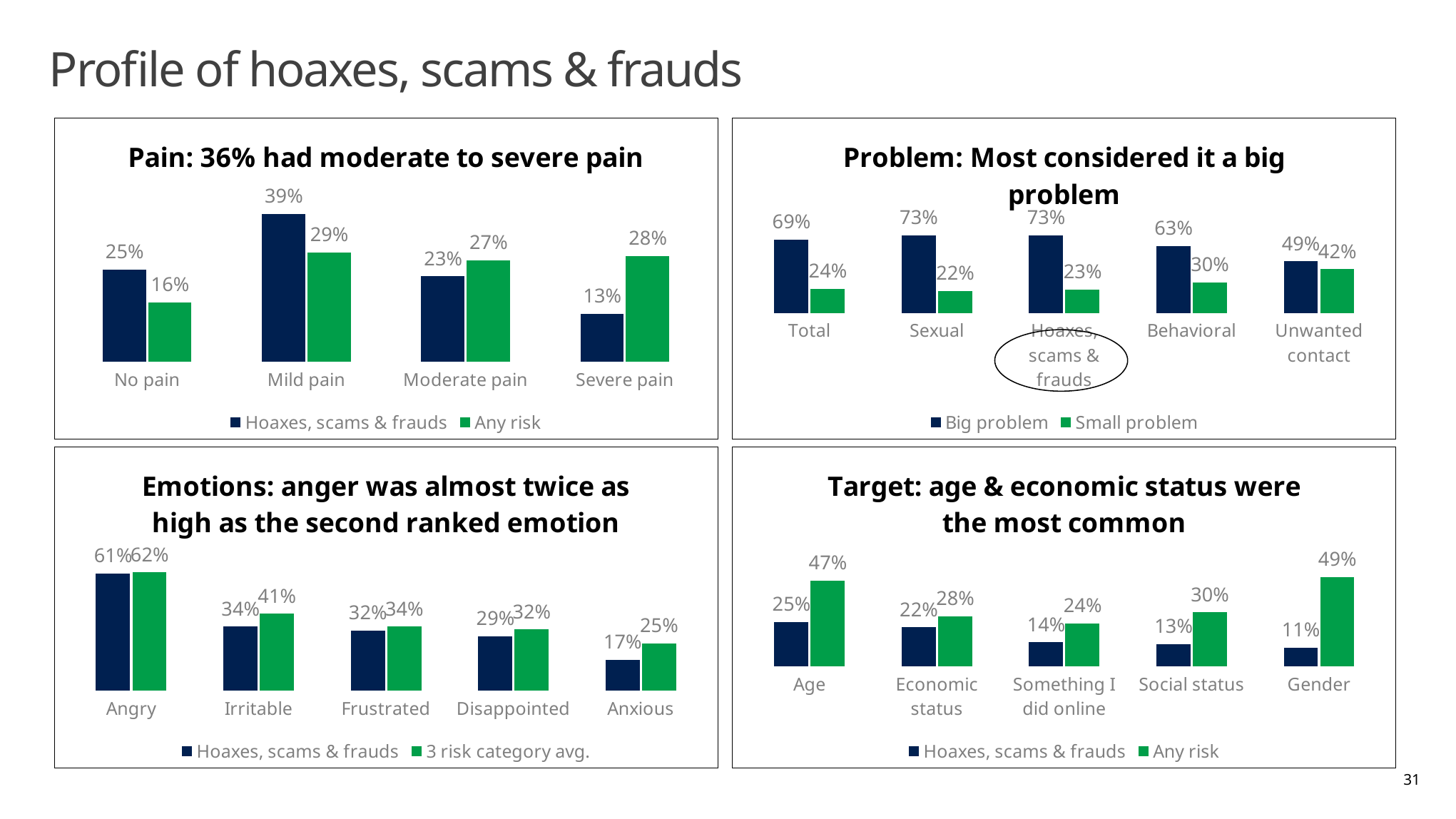
In the Target chart, what is the Any risk value for Gender? 49% What kind of chart is the Target chart? Bar chart In the Problem chart, what is the Big problem value for Behavioral? 63% In the Target chart, which is larger for Social status: Hoaxes, scams & frauds or Any risk? Any risk In the Pain chart, which category has the lowest value for Hoaxes, scams & frauds? Severe pain In the Pain chart, what is the value for Mild pain in the Hoaxes, scams & frauds series? 39% In the Problem chart, what is the difference between the Big problem and Small problem values for Total? 45% In the Emotions chart, what is the difference between the 3 risk category avg. and Hoaxes, scams & frauds values for Anxious? 8% In the Emotions chart, what is the value for Angry in the Hoaxes, scams & frauds series? 61% In the Pain chart, what is the value for Severe pain in the Any risk series? 28% In the Problem chart, how many categories are shown on the x axis? 5 In the Emotions chart, which emotion has the highest value for the 3 risk category avg. series? Angry